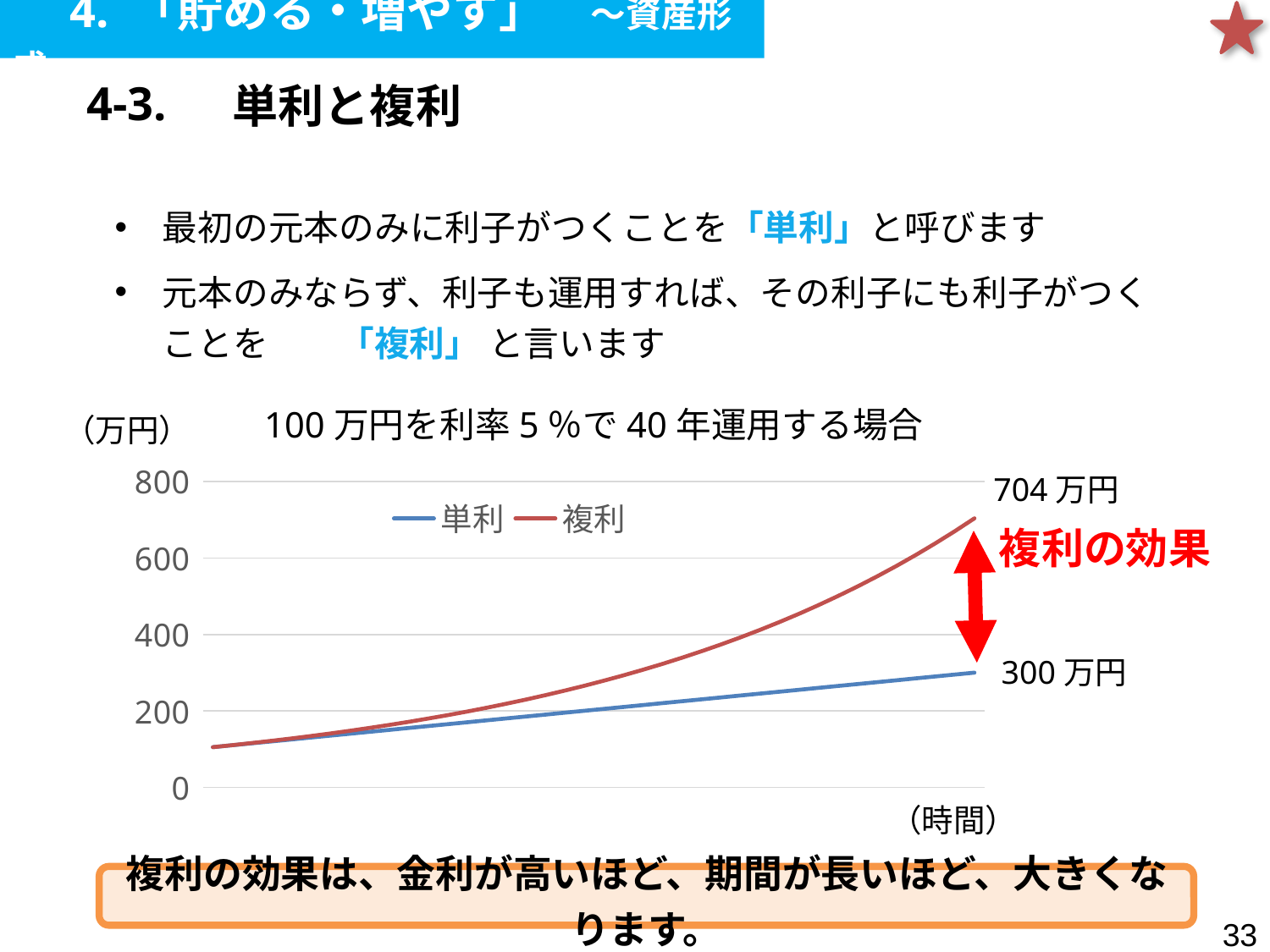
How many series does the legend list? 2 Which line ends at a higher value, 単利 or 複利? 複利 Is the final value of the 単利 line greater or less than 400? less Do the values of the 複利 line rise or fall along the x axis? Rise What is the title of the chart? 100万円を利率5％で40年運用する場合 Is the final value of the 複利 line greater or less than 600? greater What is the final value of the 複利 line shown on the chart? 704万円 What is the difference between the final values of the 複利 and 単利 lines? 404万円 What is the final value of the 単利 line shown on the chart? 300万円 What colour is the 複利 line in the chart? Red What kind of chart is shown on the slide? Line chart